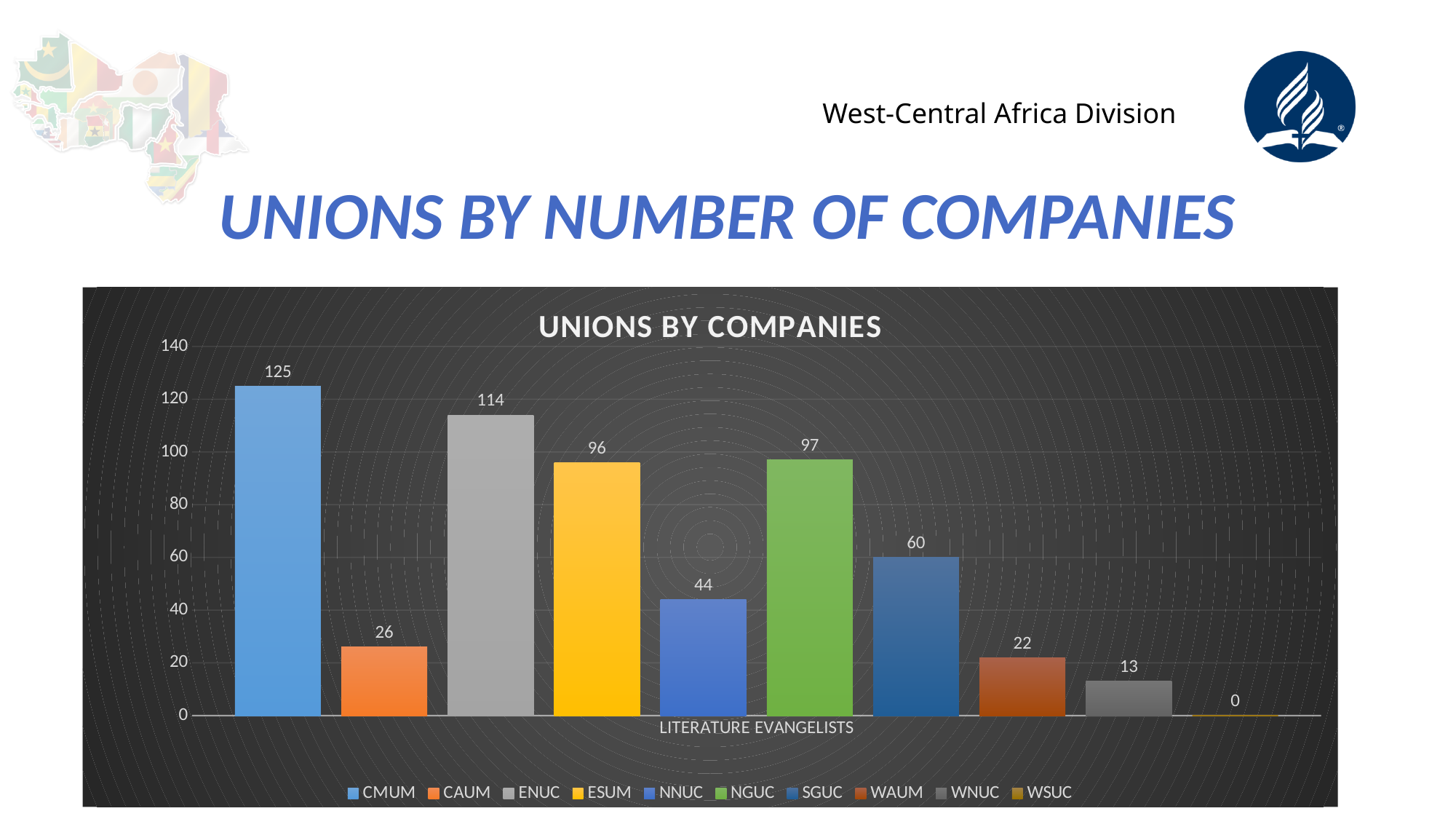
What is the value for CMUM in the Unions by Companies chart? 125 Is the value for WAUM in the Unions by Companies chart greater or less than 40? less What is the label shown on the x axis of the Unions by Companies chart? LITERATURE EVANGELISTS Which union has the highest value in the Unions by Companies chart? CMUM What is the value for ENUC in the Unions by Companies chart? 114 Which has a larger value in the Unions by Companies chart, NNUC or SGUC? SGUC Which union has the lowest value in the Unions by Companies chart? WSUC What is the difference between the values for CMUM and ENUC in the Unions by Companies chart? 11 What is the value for SGUC in the Unions by Companies chart? 60 What is the value for WSUC in the Unions by Companies chart? 0 How many series does the legend of the Unions by Companies chart list? 10 What kind of chart is the Unions by Companies chart? Bar chart